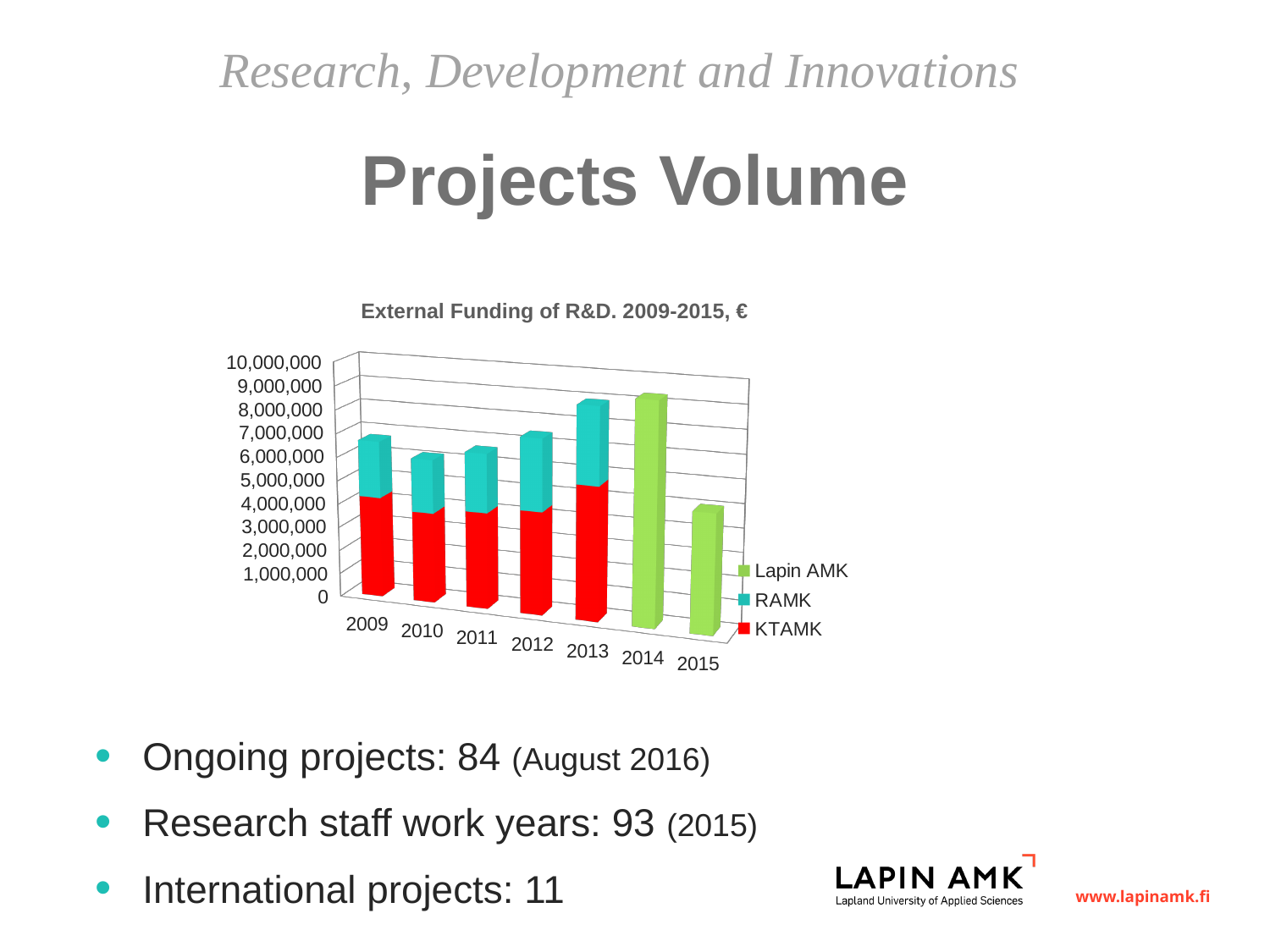
What kind of chart is shown on the slide? bar chart How many years are shown on the x axis of the chart? 7 Which series is shown in green in the legend? Lapin AMK Is the total external funding for 2013 greater or less than 7,000,000? greater Do the total bars rise or fall from 2010 to 2013? rise Is the total external funding for 2010 greater or less than 7,000,000? less Which year has the lowest total external funding? 2015 Which year has the larger total external funding, 2013 or 2010? 2013 Is the KTAMK value for 2009 greater or less than 3,000,000? greater What is the title of the chart? External Funding of R&D. 2009-2015, € How many series does the legend list? 3